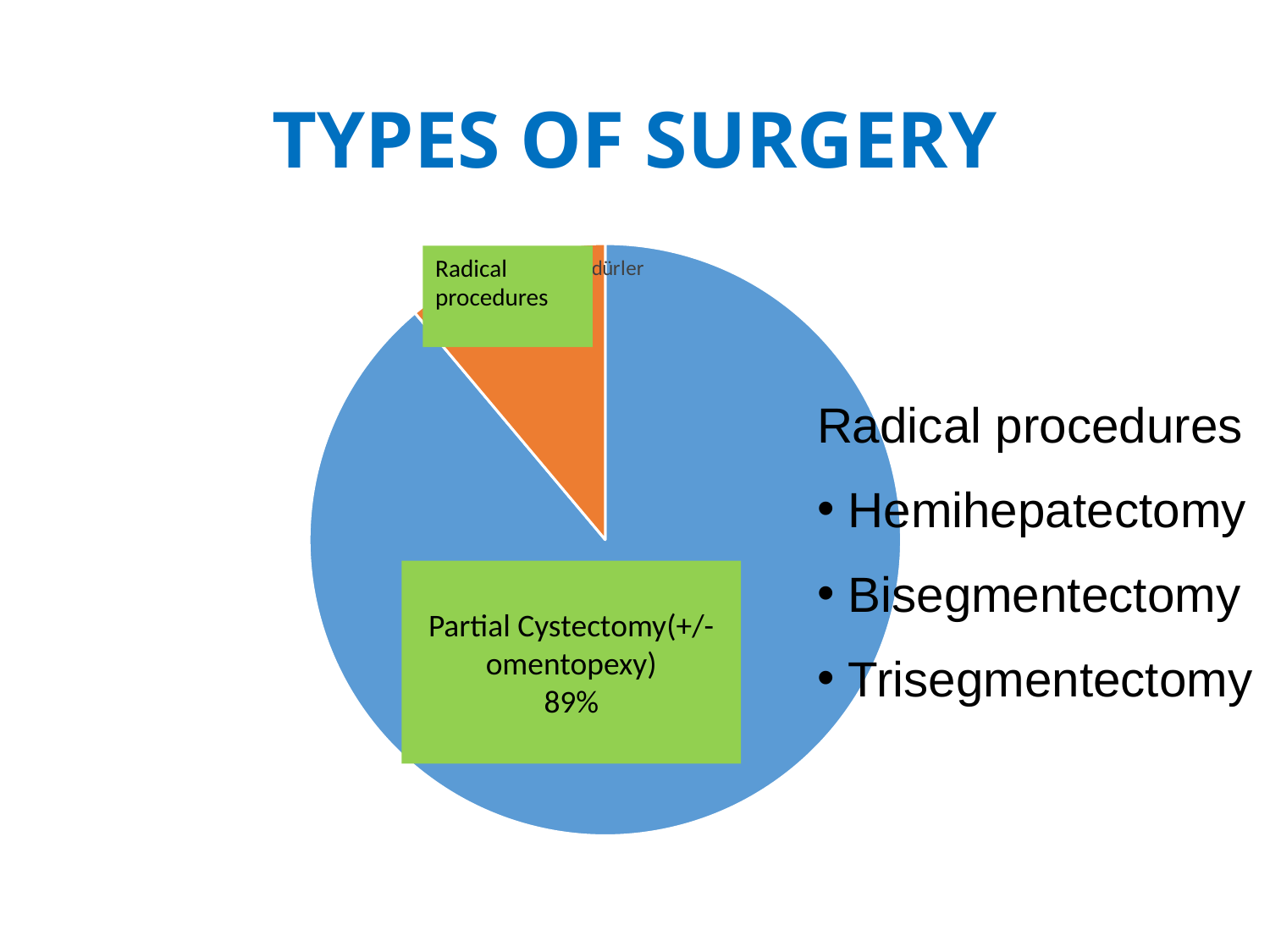
Which is larger in the pie chart: Partial Cystectomy (+/- omentopexy) or Radical procedures? Partial Cystectomy (+/- omentopexy) Which slice of the pie chart is the smallest? Radical procedures What colour is the Partial Cystectomy (+/- omentopexy) slice in the pie chart? blue What share of the pie does Partial Cystectomy (+/- omentopexy) account for? 89% Which slice of the pie chart is the largest? Partial Cystectomy (+/- omentopexy) What kind of chart is shown on the slide? pie chart What colour is the Radical procedures slice in the pie chart? orange Is the share for Partial Cystectomy (+/- omentopexy) greater or less than 50%? greater How many slices does the pie chart have? 2 Is the share for Radical procedures greater or less than 50%? less